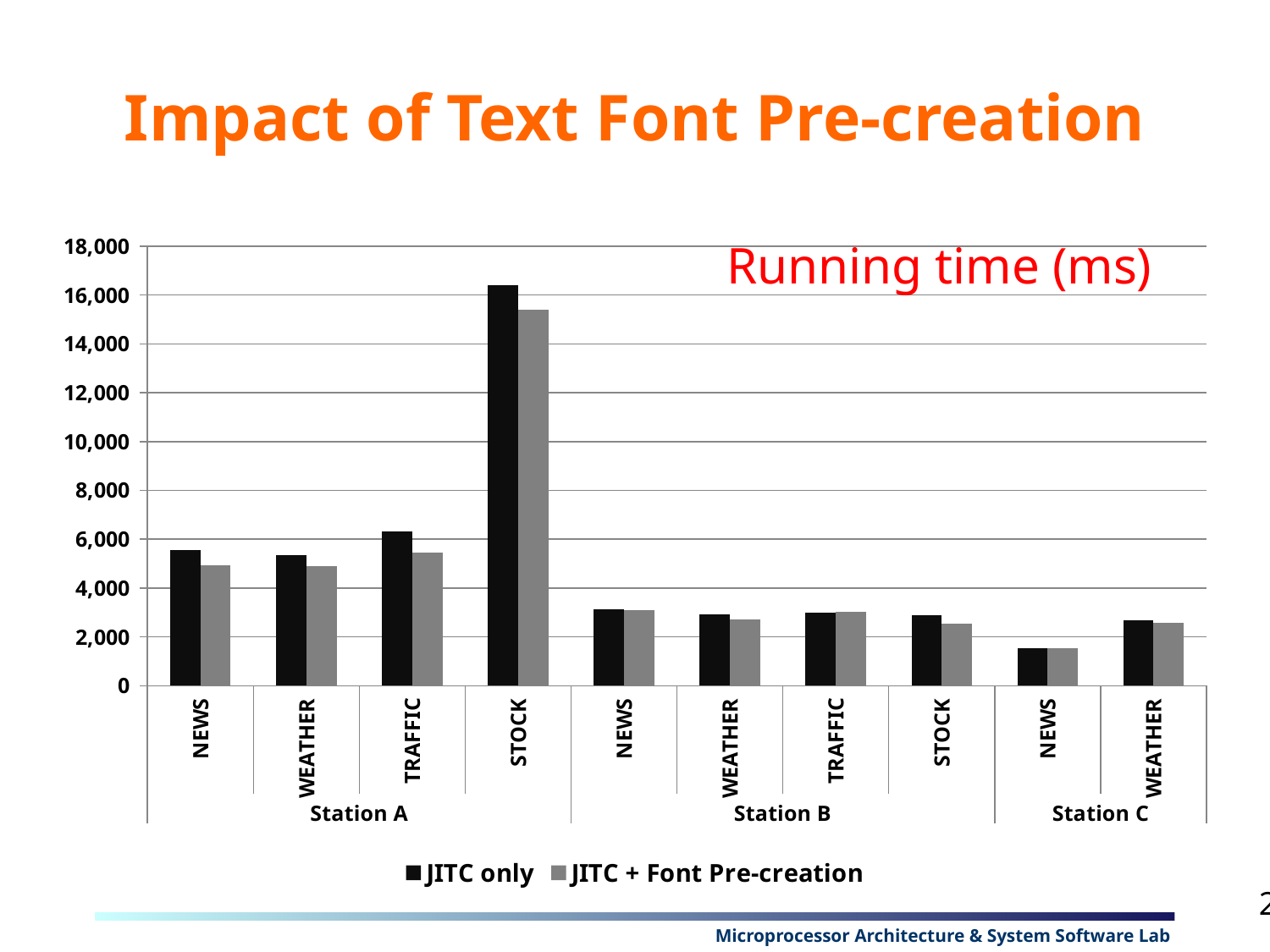
For Station A STOCK, which series has the larger value: JITC only or JITC + Font Pre-creation? JITC only Is the JITC only value for Station A TRAFFIC greater or less than 6,000? greater Which category has the highest JITC only running time? Station A STOCK Is the JITC + Font Pre-creation value for Station A STOCK greater or less than 16,000? less Is the JITC only value for Station A STOCK greater or less than 16,000? greater What unit is the running time measured in, according to the label on the chart? ms How many series does the legend list? 2 What kind of chart is shown on the slide? bar chart For the JITC only series, which is larger: Station A NEWS or Station B NEWS? Station A NEWS How many categories (bar groups) are plotted along the x axis? 10 Which category has the lowest JITC only running time? Station C NEWS